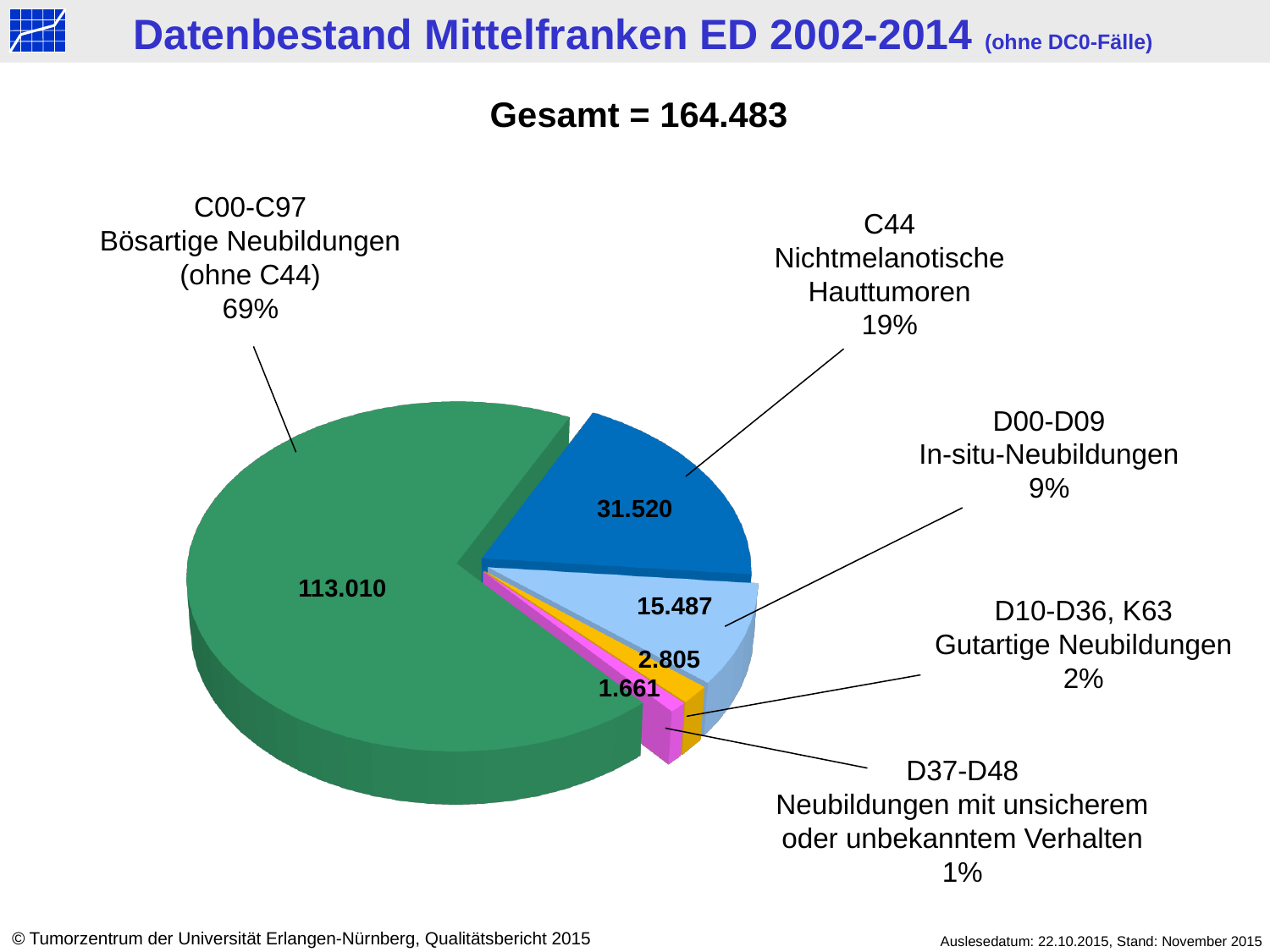
What share of the pie does D10-D36, K63 Gutartige Neubildungen represent? 2% What is the value for C00-C97 Bösartige Neubildungen (ohne C44)? 113.010 Which category has the largest slice? C00-C97 Bösartige Neubildungen (ohne C44) What is the value for D37-D48 Neubildungen mit unsicherem oder unbekanntem Verhalten? 1.661 What kind of chart is shown on the slide? pie chart What is the total (Gesamt) shown above the pie chart? 164.483 Which category has the smallest slice? D37-D48 Neubildungen mit unsicherem oder unbekanntem Verhalten What is the value for D00-D09 In-situ-Neubildungen? 15.487 How many slices does the pie chart have? 5 What is the value for C44 Nichtmelanotische Hauttumoren? 31.520 Which is larger, the value for C44 Nichtmelanotische Hauttumoren or the value for D00-D09 In-situ-Neubildungen? C44 Nichtmelanotische Hauttumoren What share of the pie does C44 Nichtmelanotische Hauttumoren represent? 19%